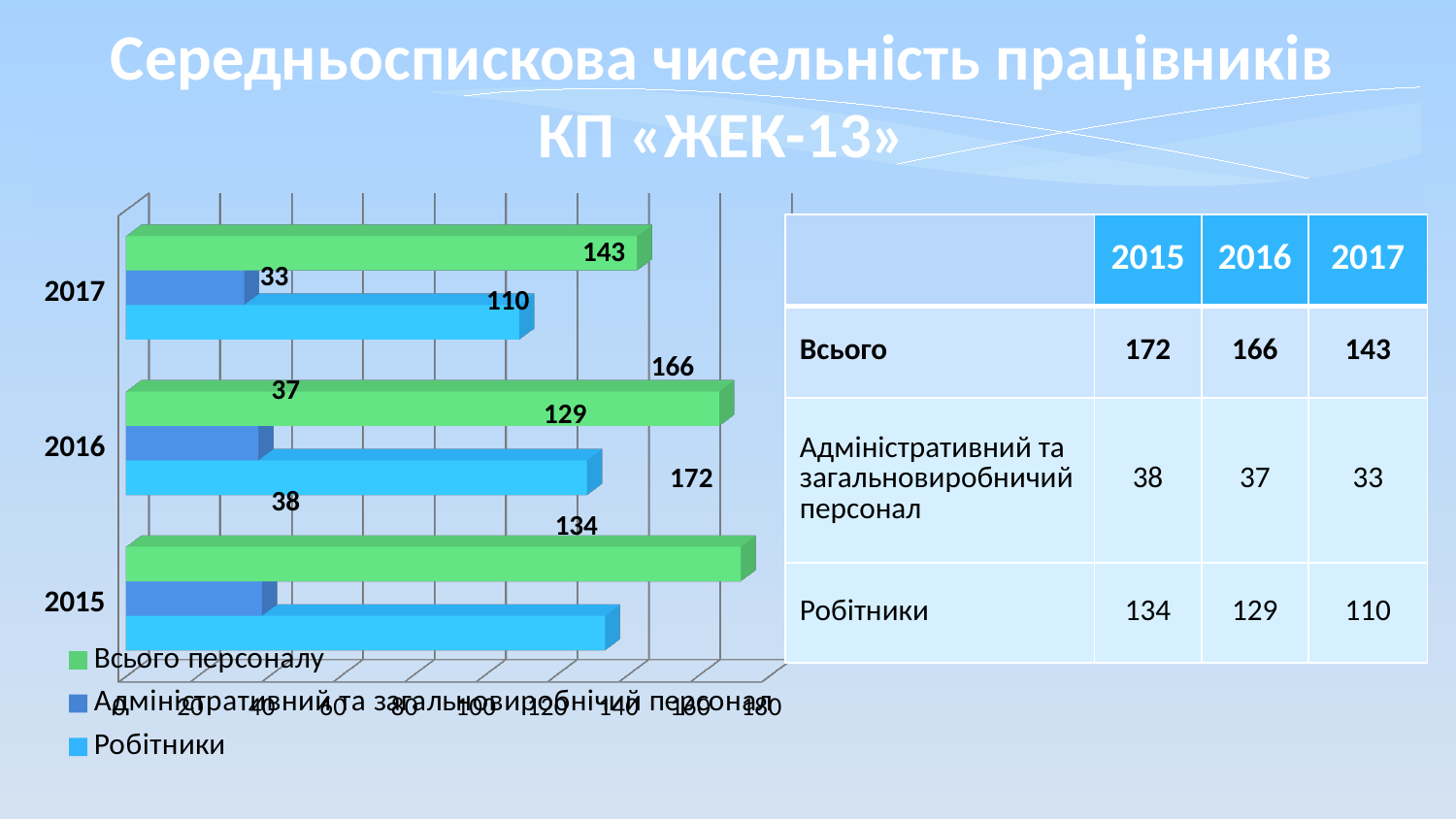
What is the value for Всього персоналу in 2017? 143 In which year is the value for Всього персоналу the highest? 2015 How many years (categories) are shown on the chart? 3 Is the value for Робітники in 2017 greater or less than 100? greater Does the value for Всього персоналу rise or fall from 2015 to 2017? fall In which year is the value for Робітники the lowest? 2017 What is the value for Робітники in 2016? 129 What kind of chart is shown on the slide? bar chart What is the value for Адміністративний та загальновиробничий персонал in 2015? 38 Which is larger: Робітники in 2015 or Робітники in 2016? Робітники in 2015 How many series does the legend list? 3 What is the difference between the Всього персоналу values for 2015 and 2017? 29